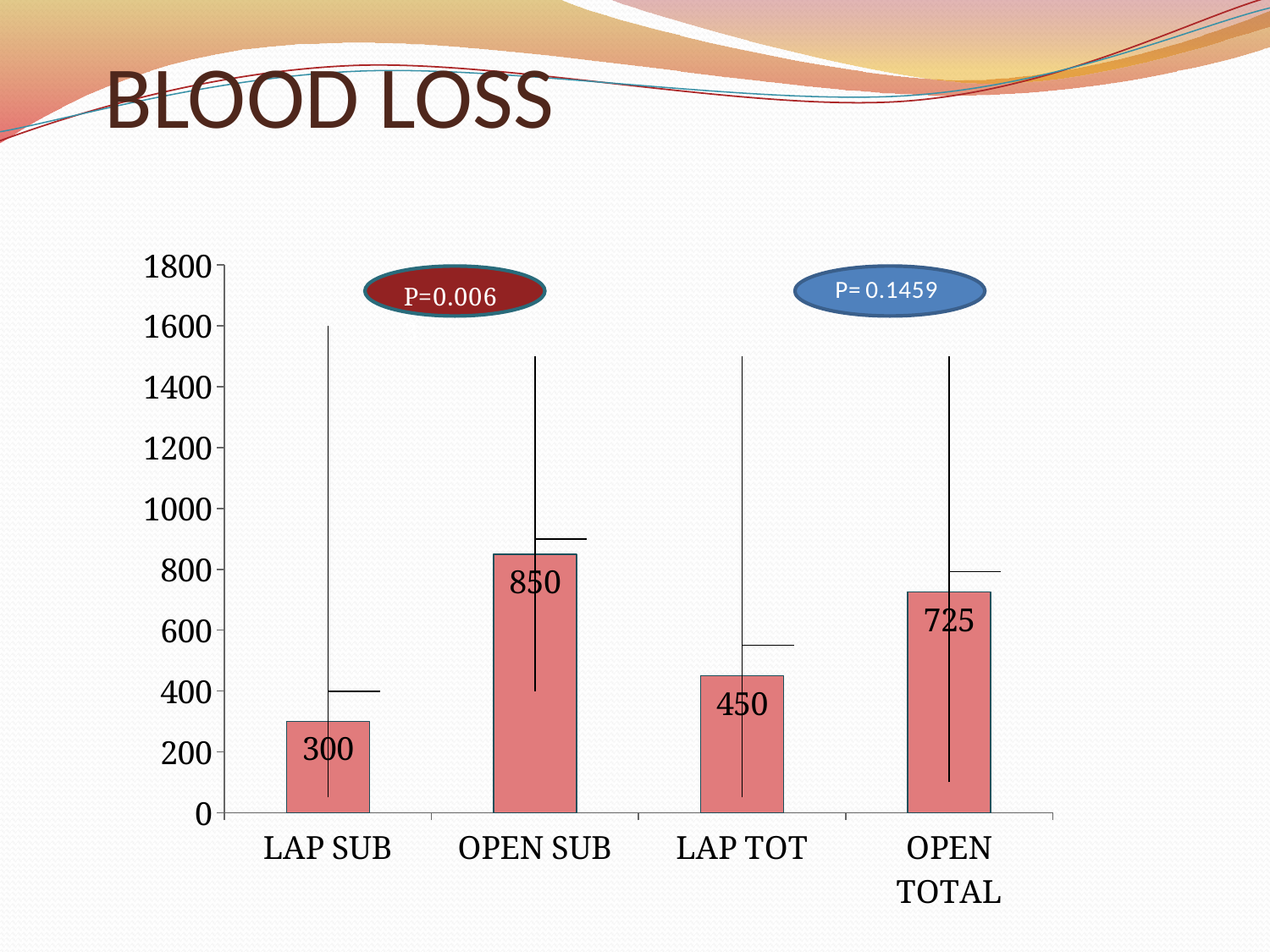
What is the title of the slide? BLOOD LOSS How many categories are shown on the x axis? 4 Which category has the highest value? OPEN SUB What is the difference between the values for OPEN TOTAL and LAP TOT? 275 What is the value for OPEN SUB? 850 What is the difference between the values for OPEN SUB and LAP SUB? 550 What is the value for OPEN TOTAL? 725 What kind of chart is shown on the slide? bar chart Which is larger, the value for LAP TOT or the value for OPEN TOTAL? OPEN TOTAL What is the value for LAP TOT? 450 Which category has the lowest value? LAP SUB What is the value for LAP SUB? 300